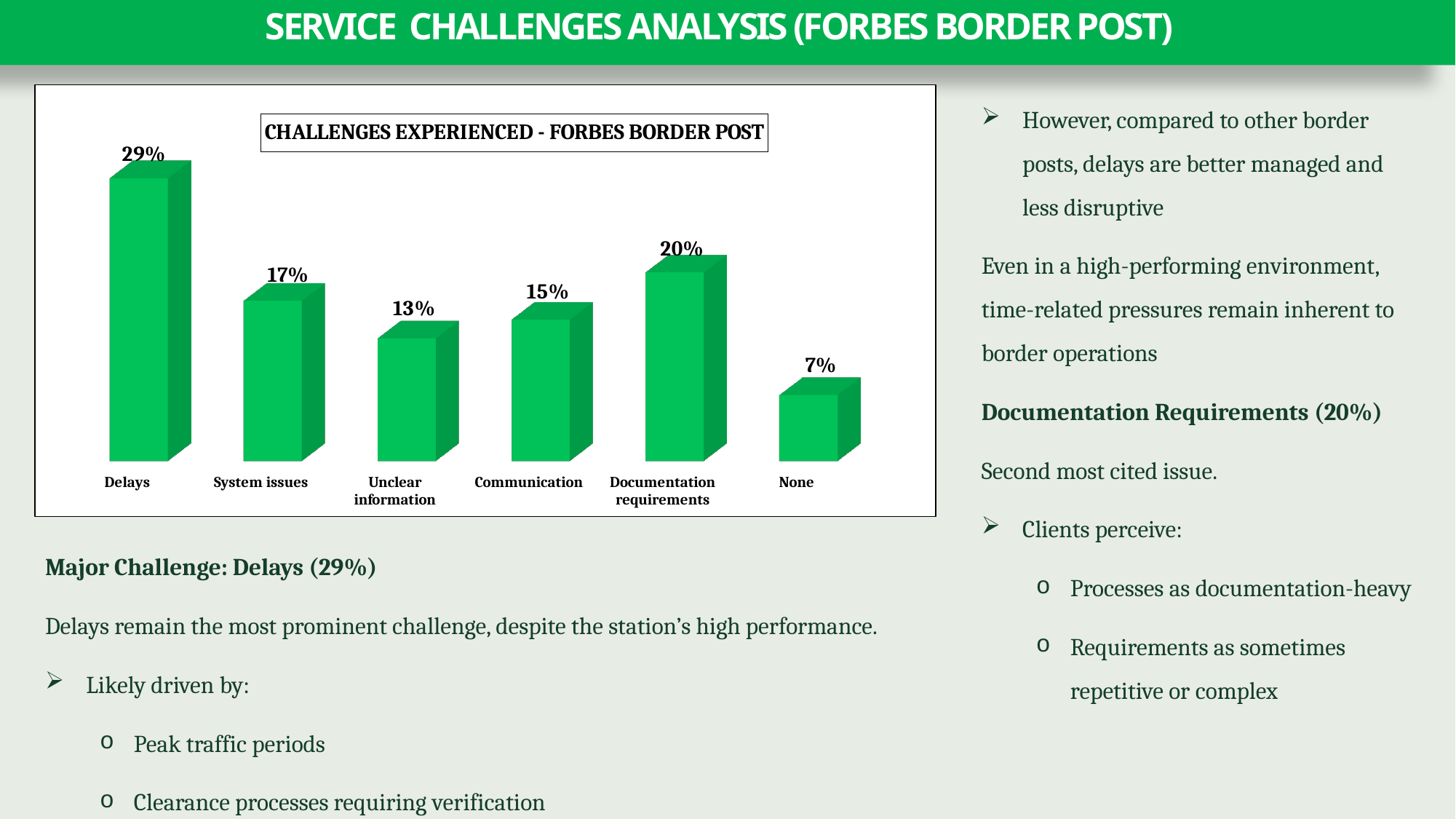
What is the title of the chart? CHALLENGES EXPERIENCED - FORBES BORDER POST Which category has the lowest percentage? None What is the difference in percentage points between Delays and Documentation requirements? 9 What percentage is shown for Delays? 29% What percentage is shown for Documentation requirements? 20% What is the difference in percentage points between System issues and Communication? 2 Which is larger, the value for System issues or the value for Unclear information? System issues How many categories are shown in the chart? 6 Which challenge has the highest percentage? Delays What type of chart is shown on the slide? Bar chart What percentage is shown for None? 7% What percentage is shown for Unclear information? 13%